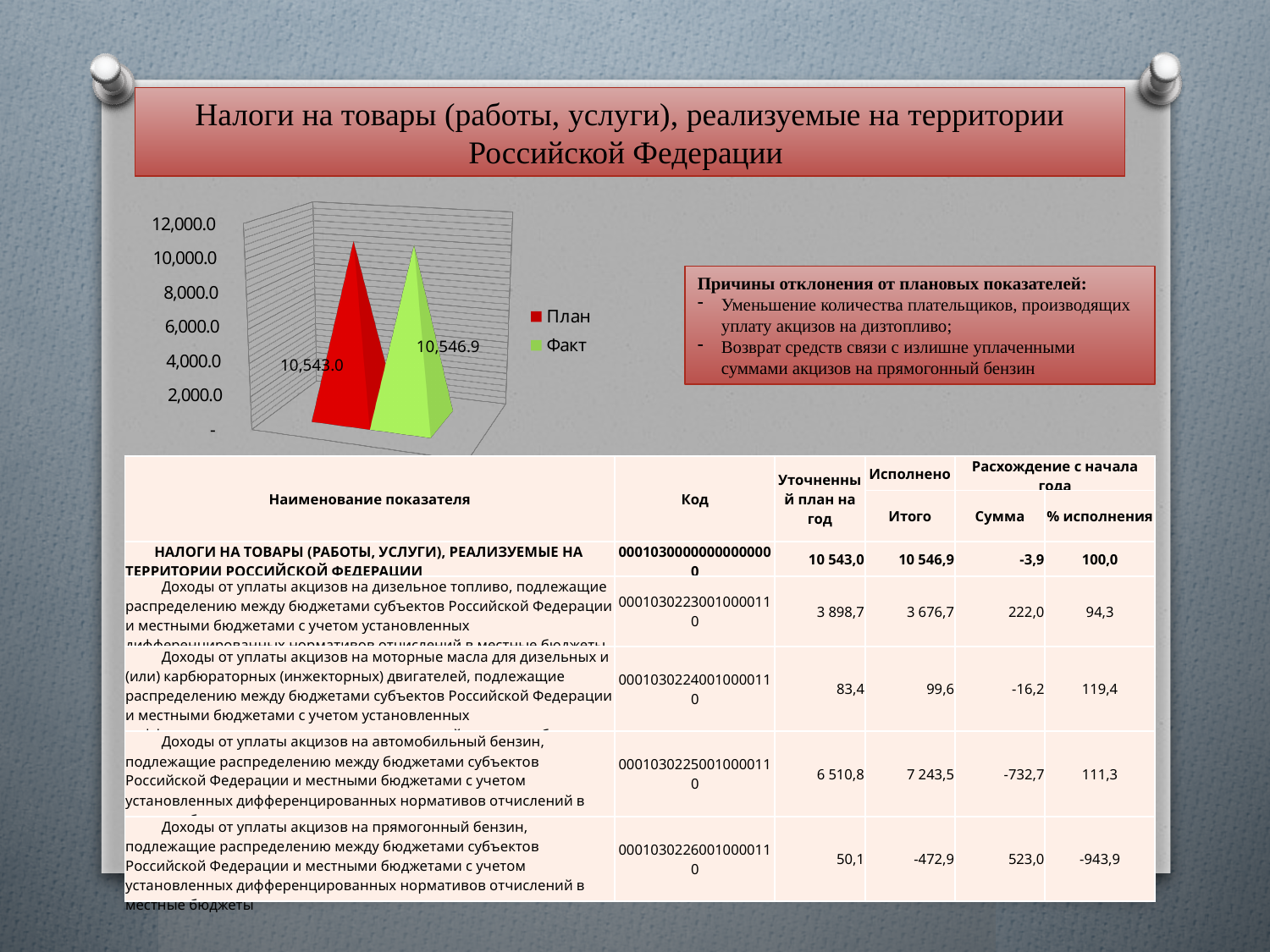
Which colour represents План in the chart legend? red What is the value shown for Факт in the chart? 10,546.9 What is the value shown for План in the chart? 10,543.0 According to the data labels, which is larger in the chart: План or Факт? Факт How many series does the chart legend list? 2 What is the difference between the Факт value and the План value in the chart? 3.9 Is the value for План in the chart greater or less than 10,000.0? greater What kind of chart is shown on the slide? bar chart How many bars are plotted in the chart? 2 Is the value for Факт in the chart greater or less than 12,000.0? less What is the highest value shown on the chart's vertical axis? 12,000.0